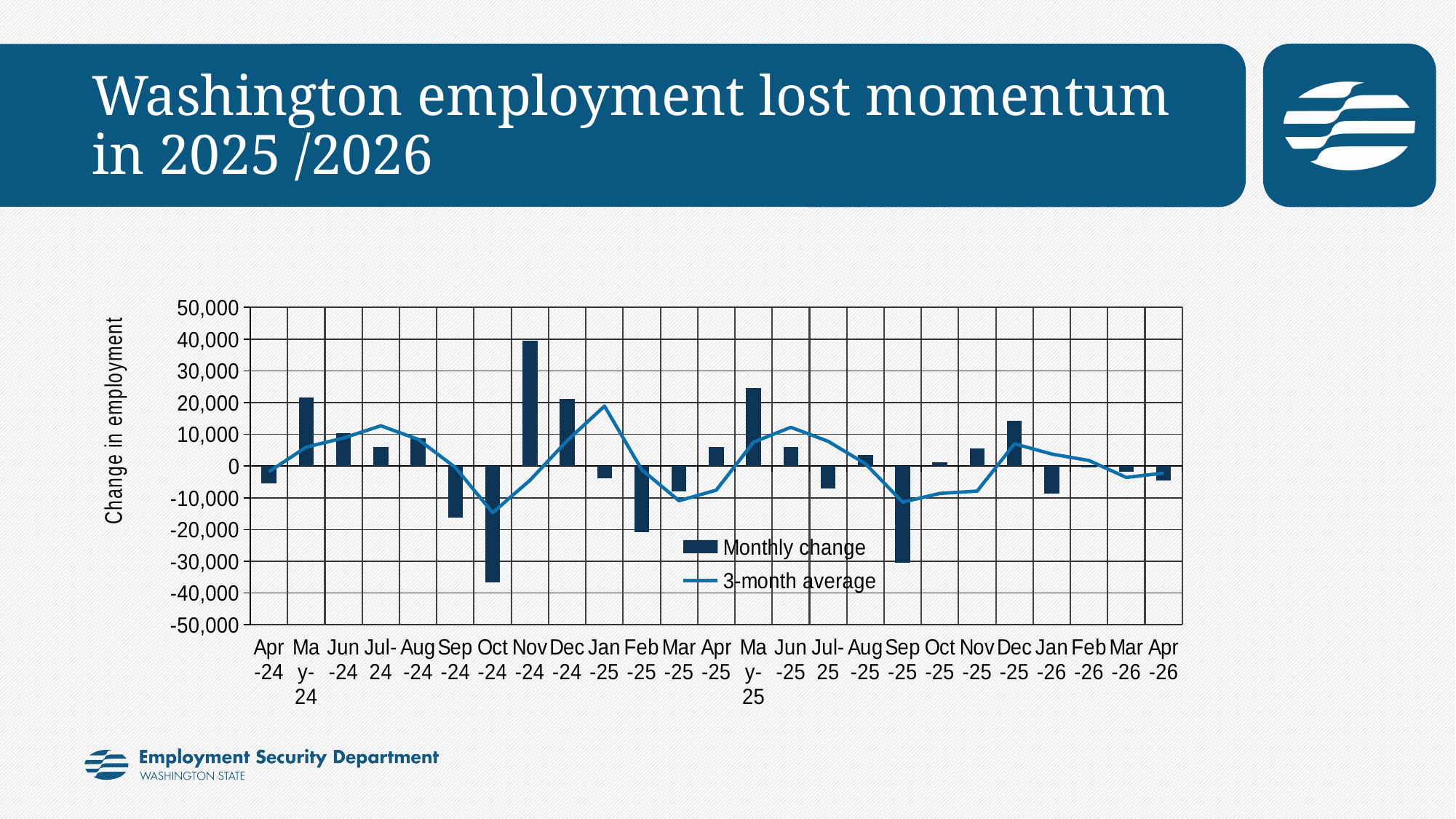
What is the label on the vertical axis? Change in employment Which month has the lowest monthly change? Oct-24 Is the monthly change for Nov-24 greater or less than 30,000? greater Which has the larger monthly change, Nov-24 or Dec-24? Nov-24 Is the monthly change for May-25 greater or less than 20,000? greater How many months are shown along the x axis? 25 Which month has the highest monthly change? Nov-24 Is the monthly change for Sep-25 greater or less than -20,000? less How many series does the legend list? 2 What are the two series named in the legend? Monthly change and 3-month average What kind of chart is shown on the slide? A bar chart with a line series overlaid